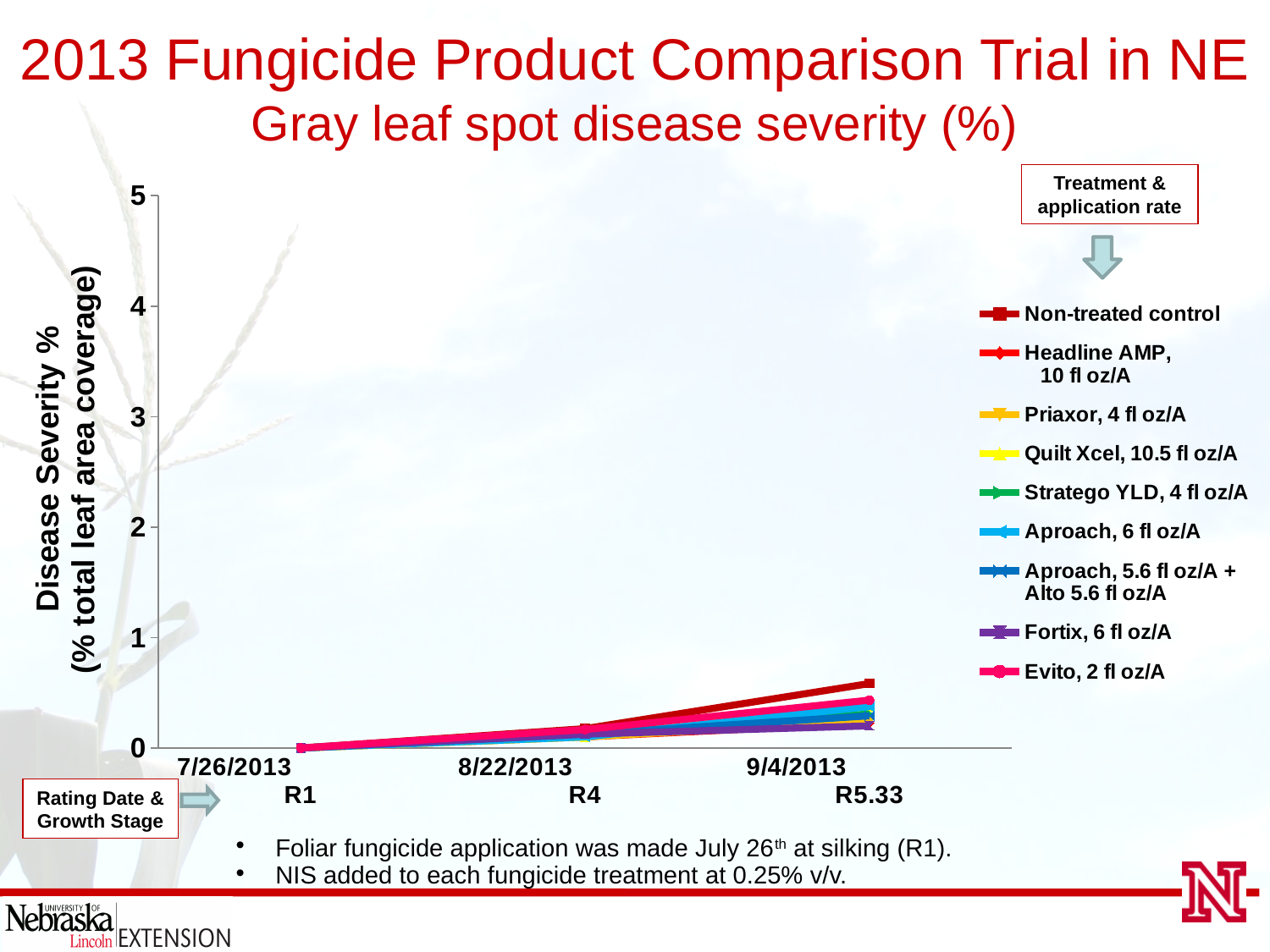
What is the disease severity for the Non-treated control on 7/26/2013? 0 Which treatment has the highest disease severity on 9/4/2013? Non-treated control Is the disease severity for the Non-treated control on 9/4/2013 greater or less than 1? less What kind of chart is shown on the slide? line chart Is the disease severity for Evito, 2 fl oz/A on 9/4/2013 greater or less than 1? less How many series does the legend list? 9 Does disease severity for the Non-treated control rise or fall from 7/26/2013 to 9/4/2013? rise What growth stage is shown under the 9/4/2013 rating date? R5.33 On 9/4/2013, which has the higher disease severity: Non-treated control or Fortix, 6 fl oz/A? Non-treated control How many rating dates are plotted along the x axis? 3 What is the label of the y axis? Disease Severity % (% total leaf area coverage)